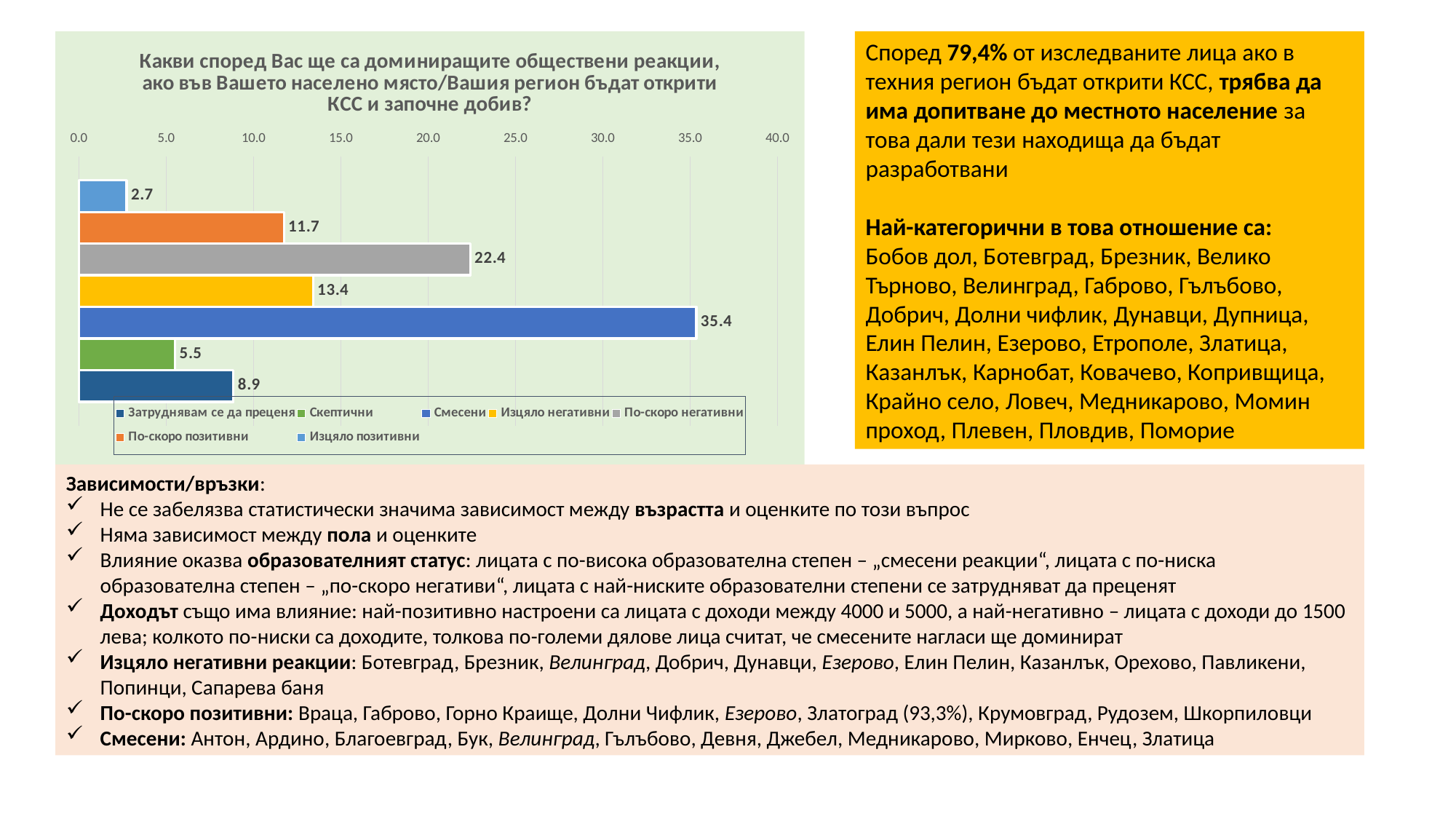
How many series does the legend list? 7 What value is shown for the "Изцяло позитивни" series? 2.7 Which series has the highest value in the chart? Смесени What value is shown for the "Затруднявам се да преценя" series? 8.9 Which series has the lowest value in the chart? Изцяло позитивни Which is larger, the value for "Изцяло негативни" or the value for "По-скоро позитивни"? Изцяло негативни What value is shown for the "Смесени" series? 35.4 Is the value for "Скептични" greater or less than 10.0? less What is the difference between the values for "Смесени" and "По-скоро негативни"? 13.0 What colour is the bar for the "По-скоро позитивни" series? Orange What kind of chart is shown on the slide? Bar chart What value is shown for the "По-скоро негативни" series? 22.4